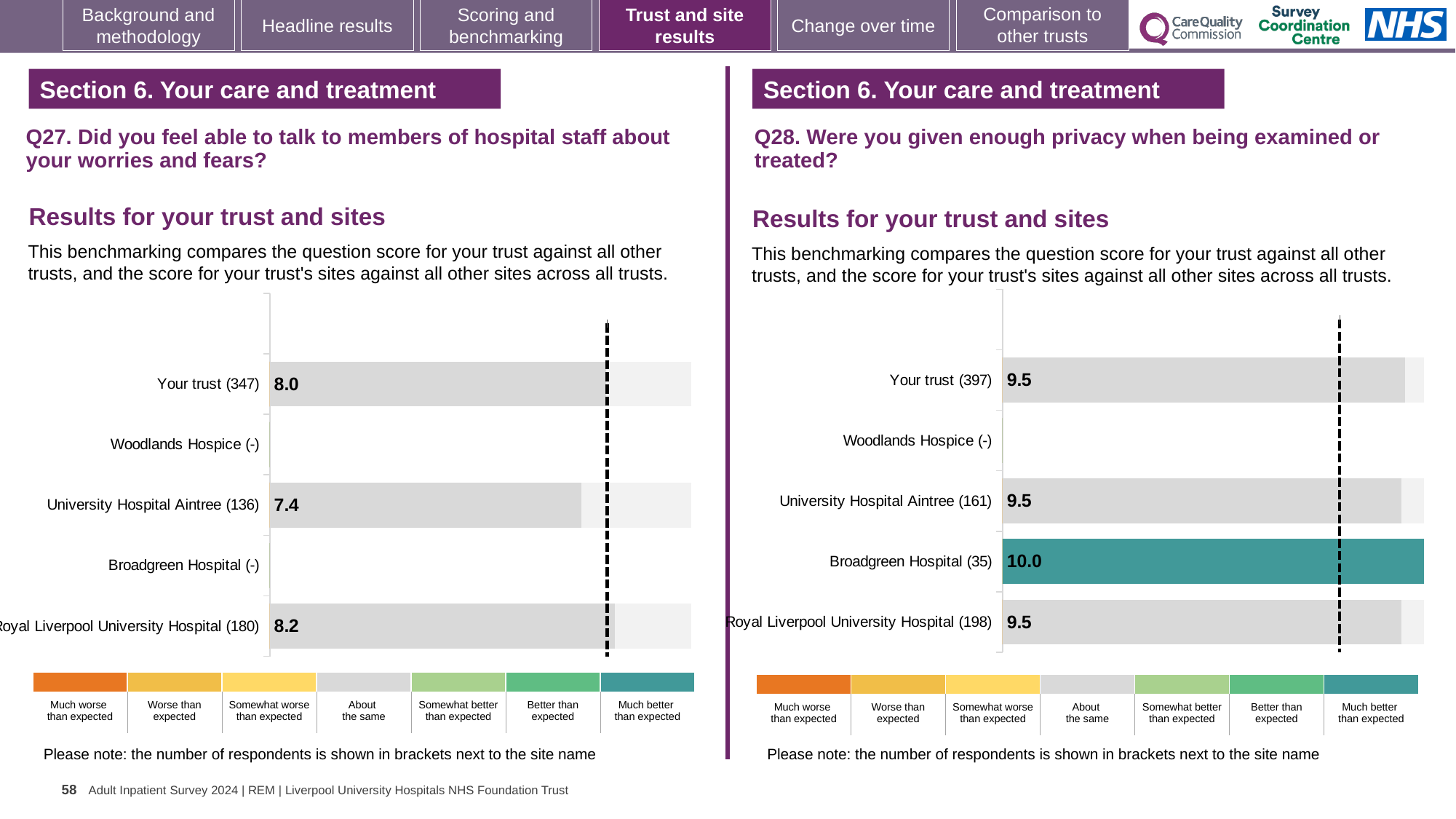
In the Q27 chart on the left, which site with a plotted score has the lowest score? University Hospital Aintree What kind of chart is used in the Q27 chart on the left? Bar chart In the Q27 chart on the left, what is the score for Royal Liverpool University Hospital? 8.2 In the Q28 chart on the right, what is the score for Your trust? 9.5 In the Q28 chart on the right, which site has the highest score? Broadgreen Hospital In the Q28 chart on the right, what is the difference between the scores for Broadgreen Hospital and Royal Liverpool University Hospital? 0.5 In the Q27 chart on the left, what is the score for Your trust? 8.0 In the Q27 chart on the left, which is larger: the score for Your trust or the score for University Hospital Aintree? Your trust In the Q27 chart on the left, what is the score for University Hospital Aintree? 7.4 In the Q27 chart on the left, what is the difference between the scores for Royal Liverpool University Hospital and University Hospital Aintree? 0.8 In the Q28 chart on the right, what is the score for Broadgreen Hospital? 10.0 How many categories are listed on the y axis of the Q28 chart on the right? 5